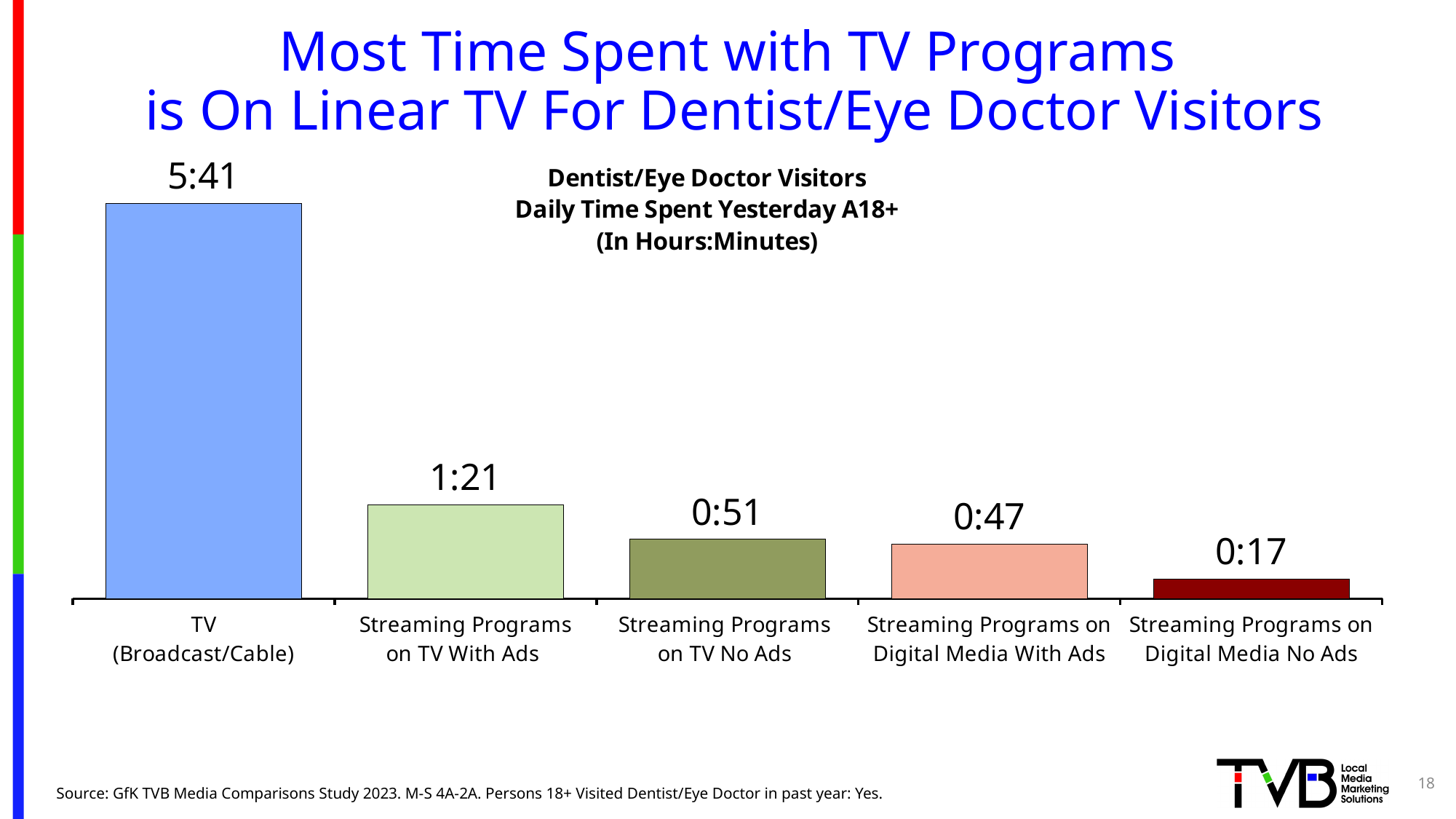
What is the daily time spent for TV (Broadcast/Cable)? 5:41 How many categories are shown in the chart? 5 Which category has the lowest daily time spent? Streaming Programs on Digital Media No Ads How much more time is spent on Streaming Programs on TV With Ads than on Streaming Programs on Digital Media No Ads? 1:04 In what units are the values in the chart expressed? Hours:Minutes What is the daily time spent for Streaming Programs on TV With Ads? 1:21 What is the daily time spent for Streaming Programs on Digital Media With Ads? 0:47 Which is larger: the time spent on Streaming Programs on TV No Ads or on Streaming Programs on Digital Media With Ads? Streaming Programs on TV No Ads What type of chart is shown on the slide? Bar chart What is the daily time spent for Streaming Programs on Digital Media No Ads? 0:17 Which category has the highest daily time spent? TV (Broadcast/Cable) What is the daily time spent for Streaming Programs on TV No Ads? 0:51